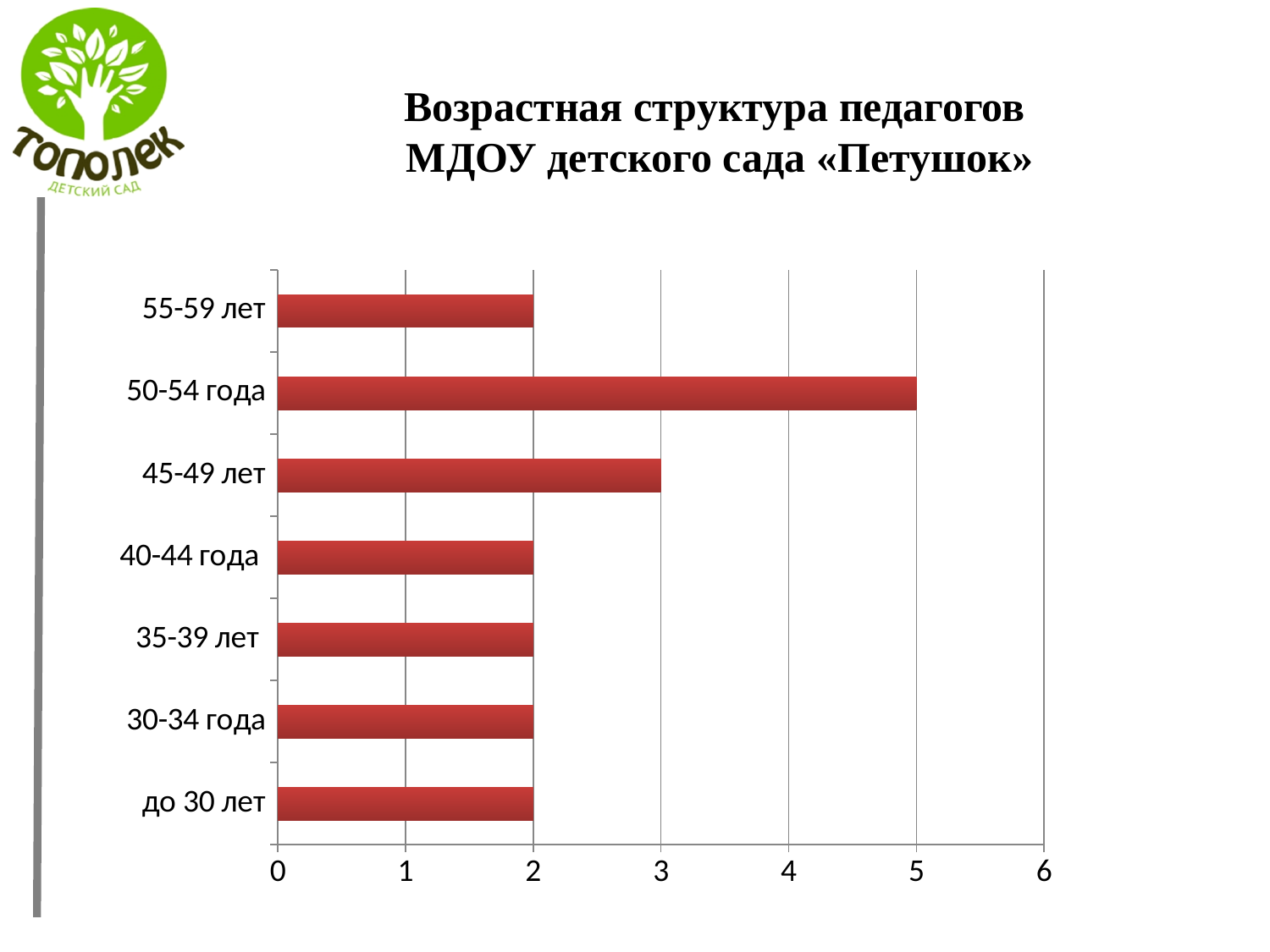
What is the title of the chart? Возрастная структура педагогов МДОУ детского сада «Петушок» What is the value for the до 30 лет category? 2 Which is larger, the value for 45-49 лет or the value for 40-44 года? 45-49 лет What is the maximum value shown on the horizontal axis? 6 What type of chart is shown on the slide? bar chart What is the difference between the values for 50-54 года and 45-49 лет? 2 How many age categories are shown in the chart? 7 What is the value for the 50-54 года category? 5 What is the value for the 45-49 лет category? 3 What is the value for the 55-59 лет category? 2 Is the value for 50-54 года greater or less than 4? greater Which age category has the highest value? 50-54 года